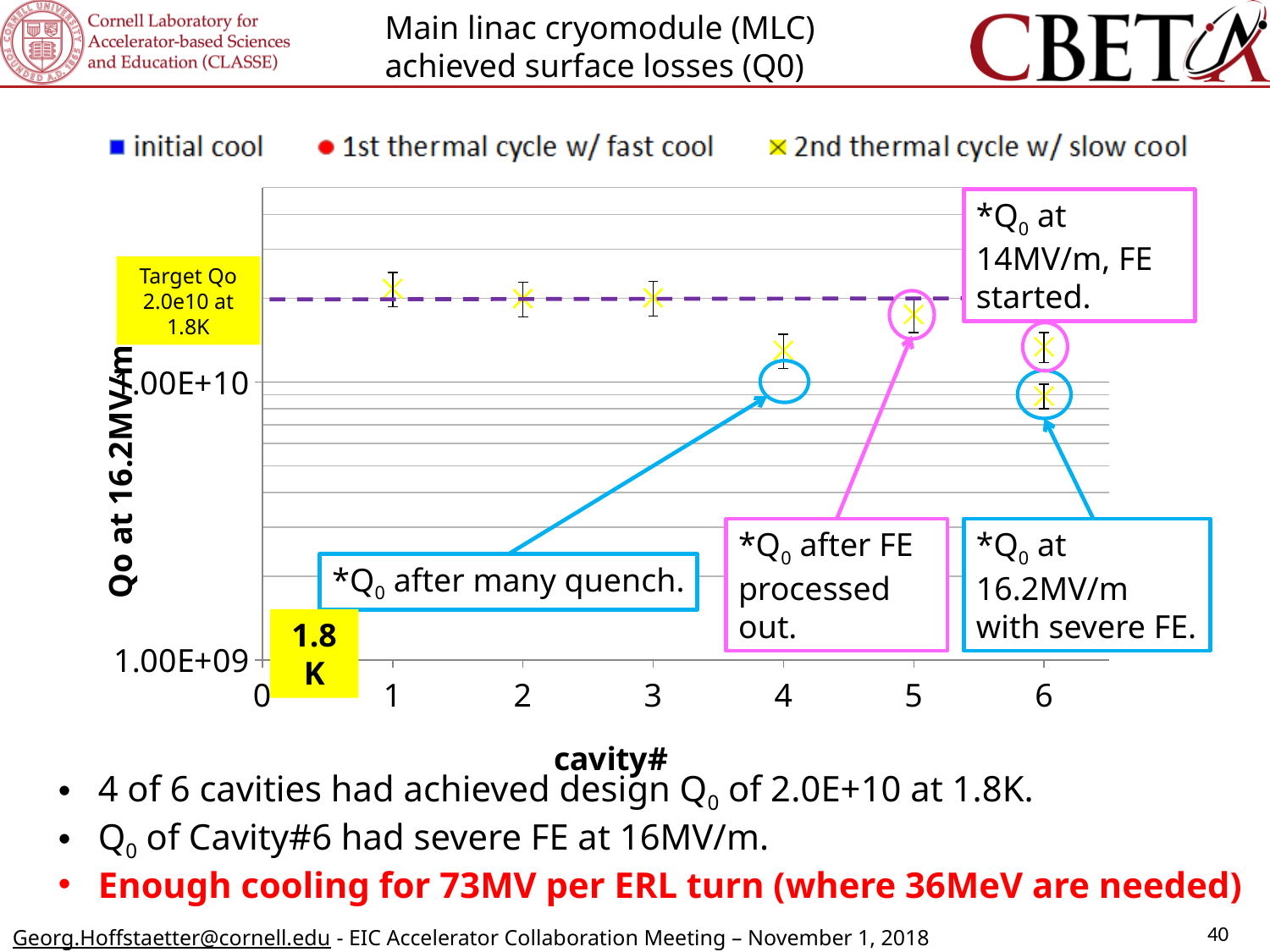
Is the Q0 value for cavity 1 greater or less than 1.00E+10? greater Which has the higher Q0, cavity 2 or the lower point of cavity 6? Cavity 2 What kind of chart is shown on the slide? Scatter chart Which cavity has the lowest plotted Q0 value? Cavity 6 Which cavities have two plotted Q0 points? Cavity 6 What is the third legend entry? 2nd thermal cycle w/ slow cool Is the Q0 value for cavity 4 greater or less than 1.00E+10? greater How many cavities are plotted along the x axis? 6 Is the lower Q0 point for cavity 6 greater or less than 1.00E+10? less How many series does the legend list? 3 Which has the higher Q0, cavity 1 or cavity 4? Cavity 1 What target Q0 does the dashed line mark? 2.0e10 at 1.8K